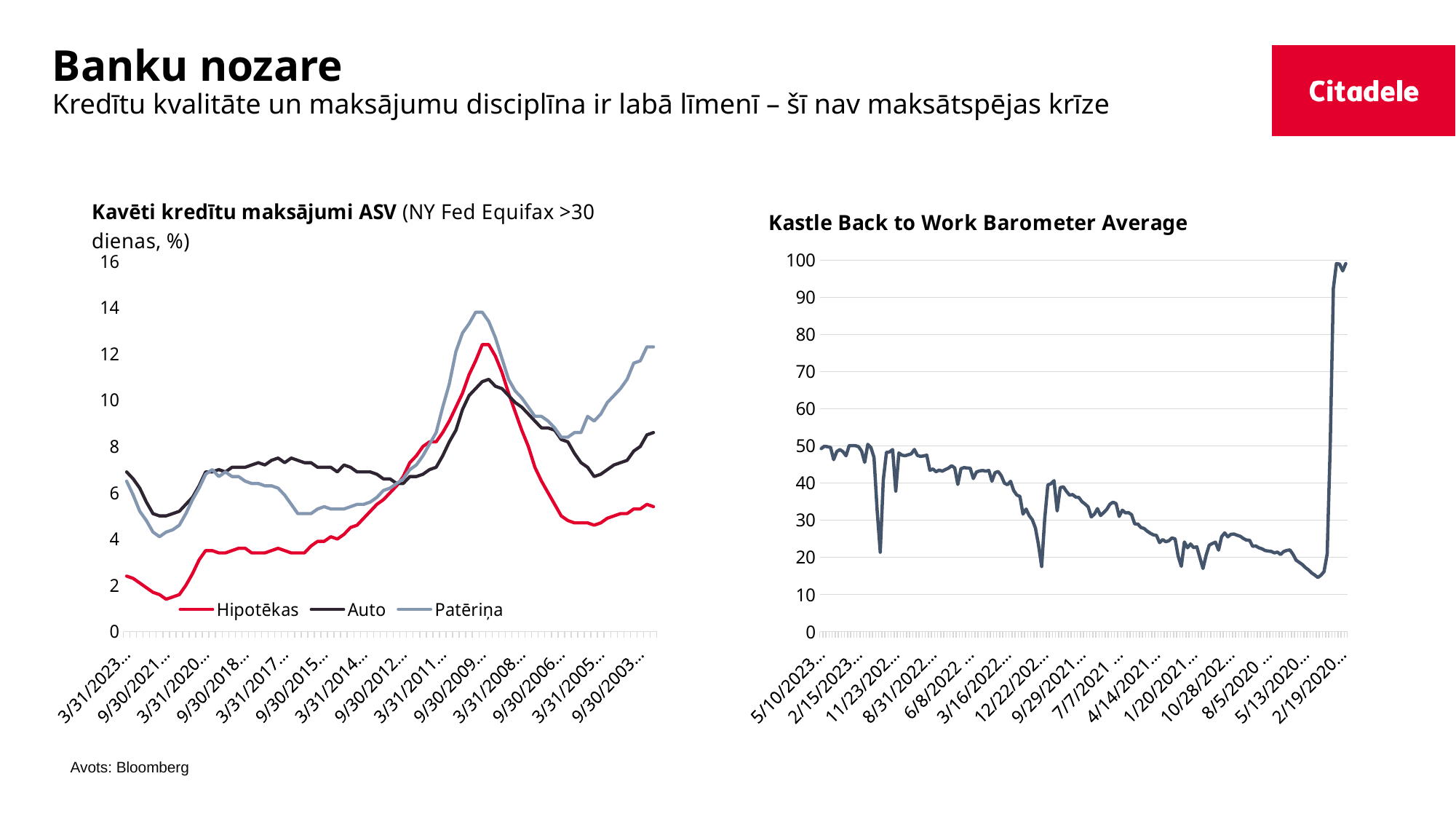
How many series does the legend of the left chart 'Kavēti kredītu maksājumi ASV' list? 3 What kind of chart is the right chart 'Kastle Back to Work Barometer Average'? line chart In the right chart 'Kastle Back to Work Barometer Average', is the value at 5/10/2023 greater or less than 60? less What is the highest value shown on the y axis of the left chart 'Kavēti kredītu maksājumi ASV'? 16 In the left chart 'Kavēti kredītu maksājumi ASV', which series has the lowest value at 3/31/2023? Hipotēkas In the left chart 'Kavēti kredītu maksājumi ASV', is the value of Hipotēkas at 3/31/2023 greater or less than 4? less What kind of chart is the left chart titled 'Kavēti kredītu maksājumi ASV'? line chart In the left chart 'Kavēti kredītu maksājumi ASV', which series reaches the highest peak over the whole period? Patēriņa In the left chart 'Kavēti kredītu maksājumi ASV', what are the three series named in the legend? Hipotēkas, Auto, Patēriņa In the left chart 'Kavēti kredītu maksājumi ASV', is the peak value of Patēriņa greater or less than 12? greater